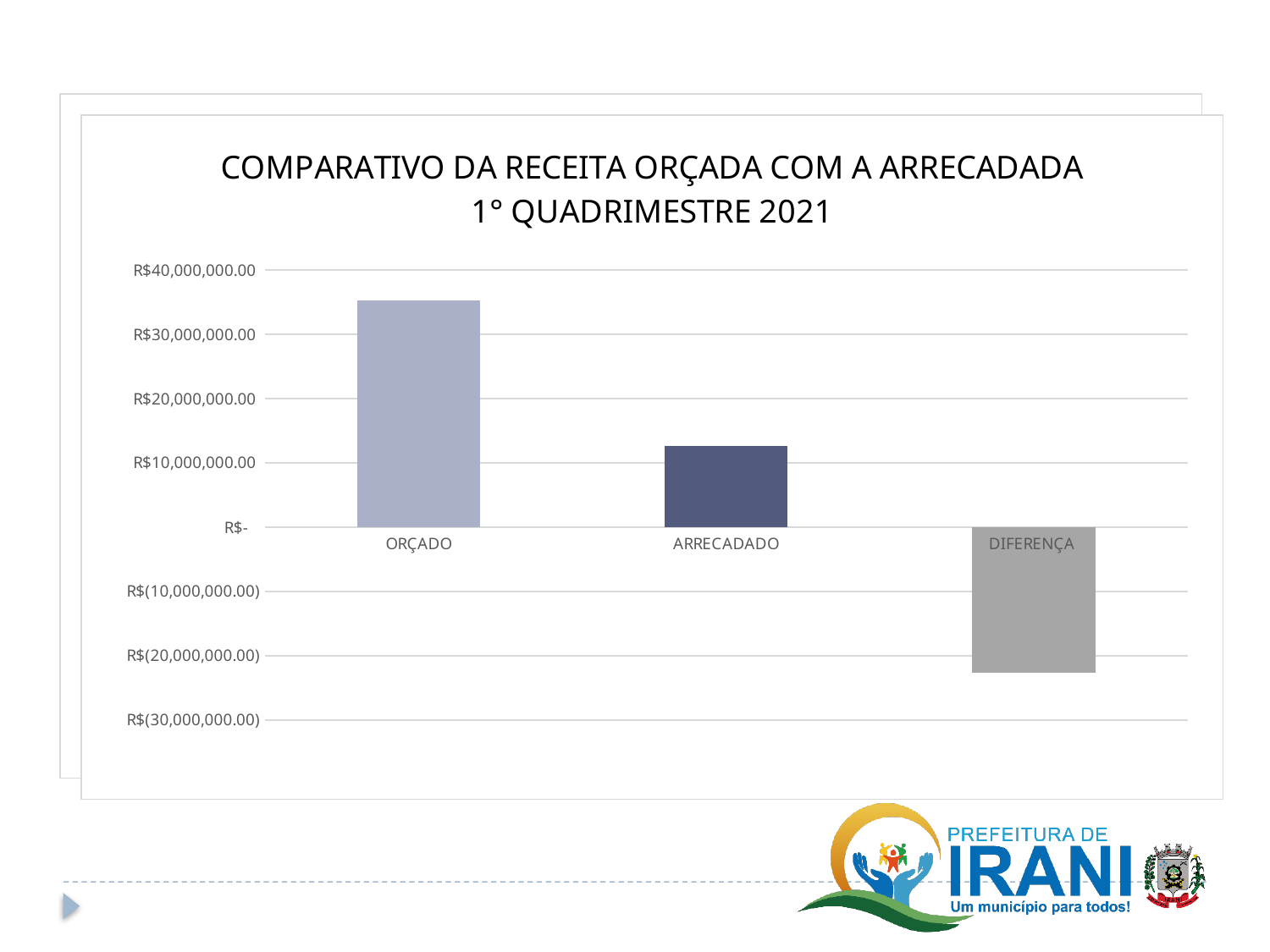
Which category has the lowest value? DIFERENÇA Is the value for ARRECADADO greater or less than R$10,000,000.00? greater What kind of chart is shown on the slide? bar chart Is the value for ORÇADO greater or less than R$30,000,000.00? greater How many categories are plotted on the chart? 3 Which category's bar extends below zero? DIFERENÇA What is the title of the chart? COMPARATIVO DA RECEITA ORÇADA COM A ARRECADADA 1° QUADRIMESTRE 2021 Is the value for DIFERENÇA greater or less than R$(20,000,000.00)? less Which is larger, the value for ORÇADO or the value for ARRECADADO? ORÇADO Which category has the highest value? ORÇADO Do the values rise or fall from left to right across the categories? fall